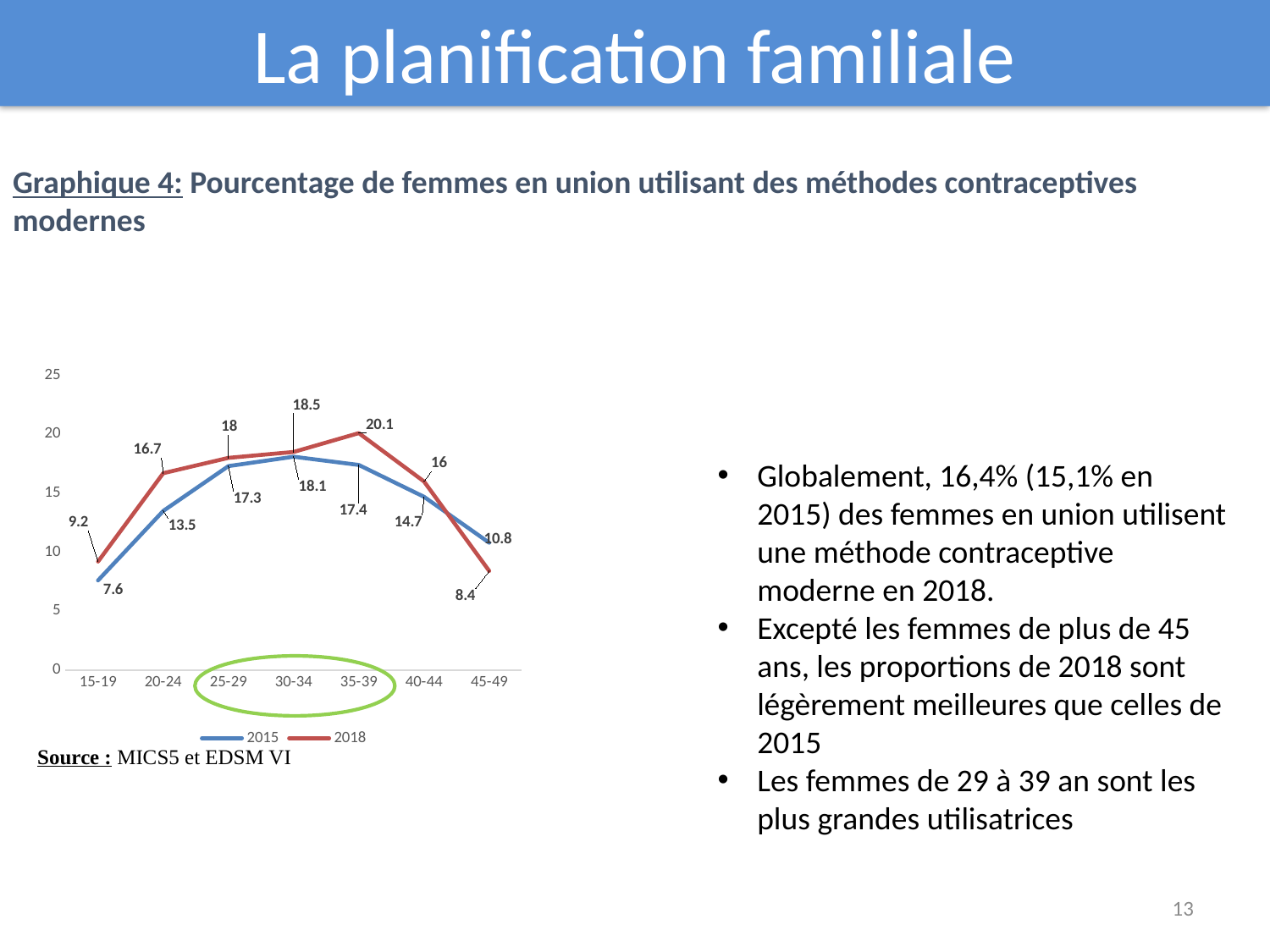
Which age group has the lowest value for the 2015 series? 15-19 What is the value for the 2018 series at age group 45-49? 8.4 What kind of chart is shown on the slide? Line chart How many series does the legend list? 2 Which age group has the highest value for the 2018 series? 35-39 How many age groups are shown on the x axis? 7 Which series is drawn in red? 2018 What is the value for the 2018 series at age group 35-39? 20.1 What is the value for the 2015 series at age group 30-34? 18.1 What is the difference between the 2018 and 2015 values at age group 35-39? 2.7 What is the value for the 2015 series at age group 15-19? 7.6 At age group 45-49, which series has the larger value, 2015 or 2018? 2015